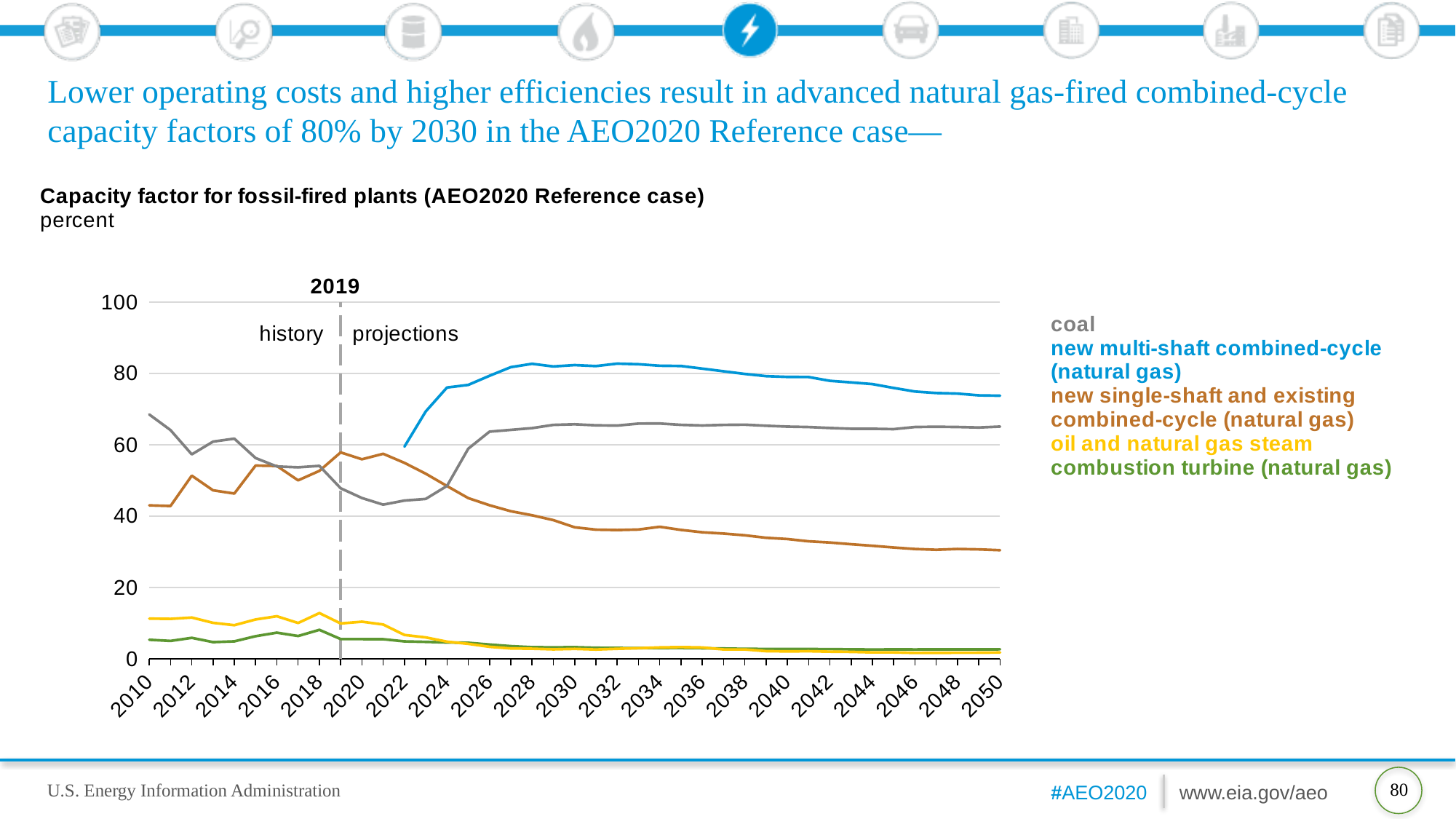
Is the value for oil and natural gas steam in 2010 greater or less than 20? less What kind of chart is shown on the slide? line chart Is the value for new single-shaft and existing combined-cycle (natural gas) in 2050 greater or less than 40? less Is the value for coal in 2050 greater or less than 60? greater In 2050, which is larger: the value for coal or the value for new single-shaft and existing combined-cycle (natural gas)? coal Which year does the dashed vertical line separating history from projections mark? 2019 How many series does the legend list? 5 Does the value for new single-shaft and existing combined-cycle (natural gas) rise or fall from 2020 to 2050? fall Which series has the lowest value in 2010? combustion turbine (natural gas) What is the title of the chart? Capacity factor for fossil-fired plants (AEO2020 Reference case) Which series has the highest value in 2050? new multi-shaft combined-cycle (natural gas)